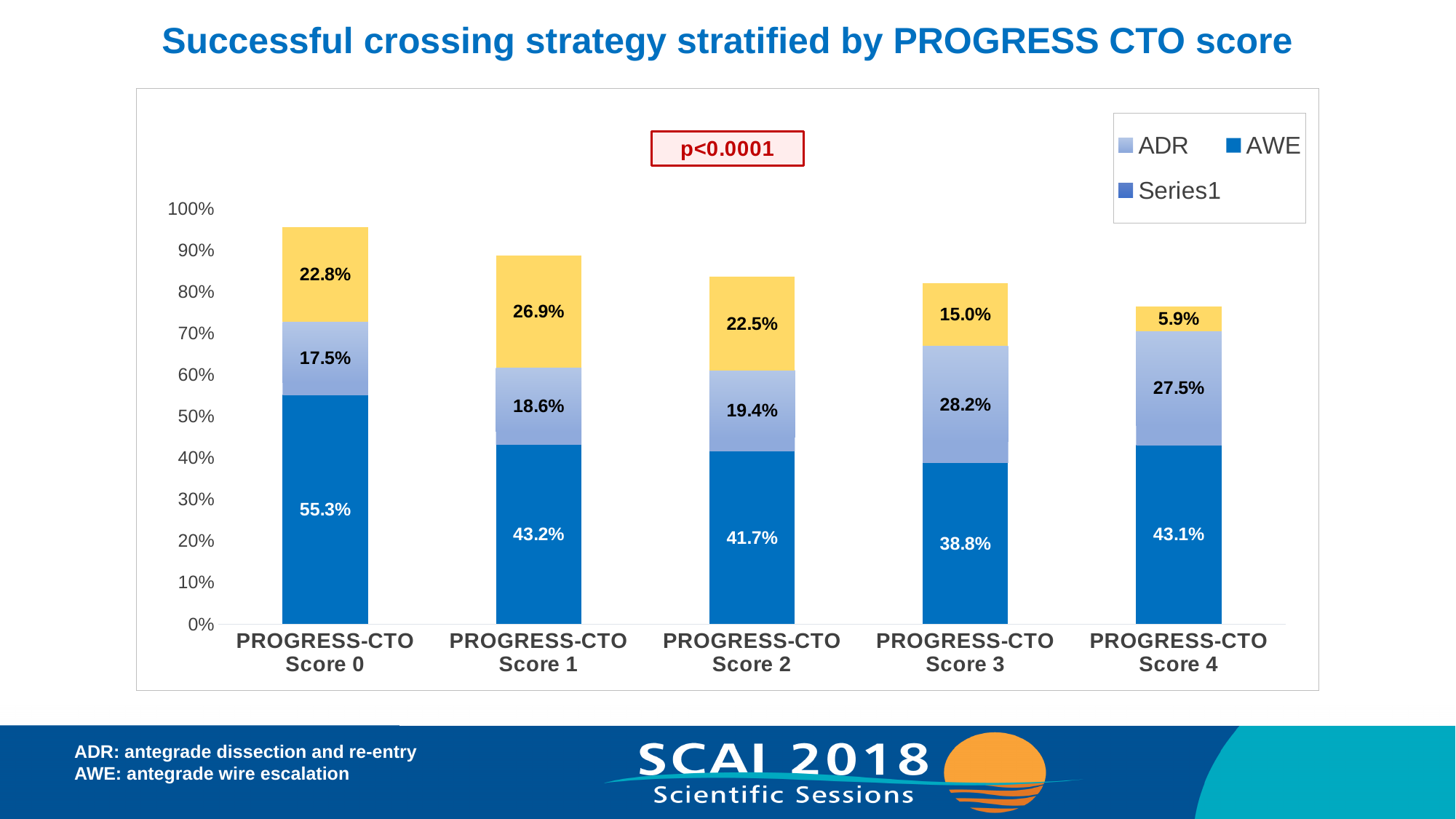
What is the value of the top (yellow) segment for PROGRESS-CTO Score 4? 5.9% Is the total height of the stacked bar for PROGRESS-CTO Score 4 greater or less than 80%? less How many series does the legend list? 3 Which PROGRESS-CTO score has the highest AWE value? PROGRESS-CTO Score 0 What is the total of the stacked bar for PROGRESS-CTO Score 0? 95.6% How many PROGRESS-CTO score categories are shown on the x axis? 5 What is the difference between the ADR values for PROGRESS-CTO Score 3 and PROGRESS-CTO Score 0? 10.7% Which is larger, the ADR value for PROGRESS-CTO Score 1 or for PROGRESS-CTO Score 4? PROGRESS-CTO Score 4 What is the ADR value for PROGRESS-CTO Score 3? 28.2% What is the AWE value for PROGRESS-CTO Score 0? 55.3% What kind of chart is shown on the slide? Stacked bar chart Which PROGRESS-CTO score has the lowest AWE value? PROGRESS-CTO Score 3